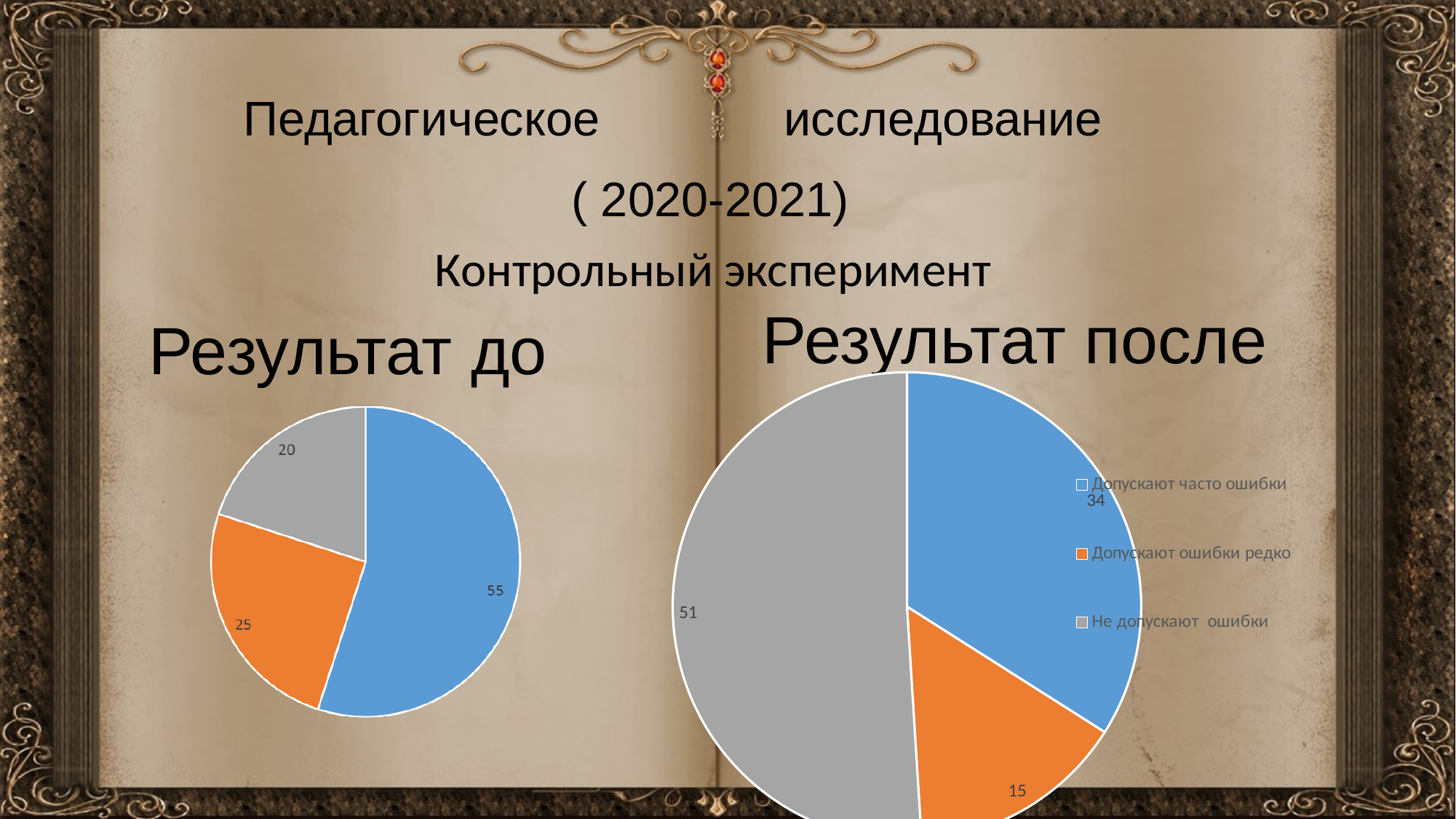
In the "Результат до" pie chart, what is the difference between the blue slice and the orange slice? 30 In the "Результат до" pie chart, what is the value of the orange slice? 25 In the "Результат после" pie chart, what is the value for "Не допускают ошибки"? 51 In the "Результат после" pie chart, what is the value for "Допускают ошибки редко"? 15 In the "Результат после" pie chart, what is the difference between "Не допускают ошибки" and "Допускают часто ошибки"? 17 In the "Результат до" pie chart, which slice is the smallest? the gray slice (20) In the "Результат после" pie chart, which category has the smallest slice? Допускают ошибки редко In the "Результат после" pie chart, which category has the largest slice? Не допускают ошибки What type of chart is used for "Результат до"? pie chart How many slices does the "Результат после" pie chart have? 3 In the "Результат до" pie chart, what is the value of the blue slice? 55 Which is larger: the gray slice in "Результат до" or the gray slice in "Результат после"? the gray slice in "Результат после" (51)